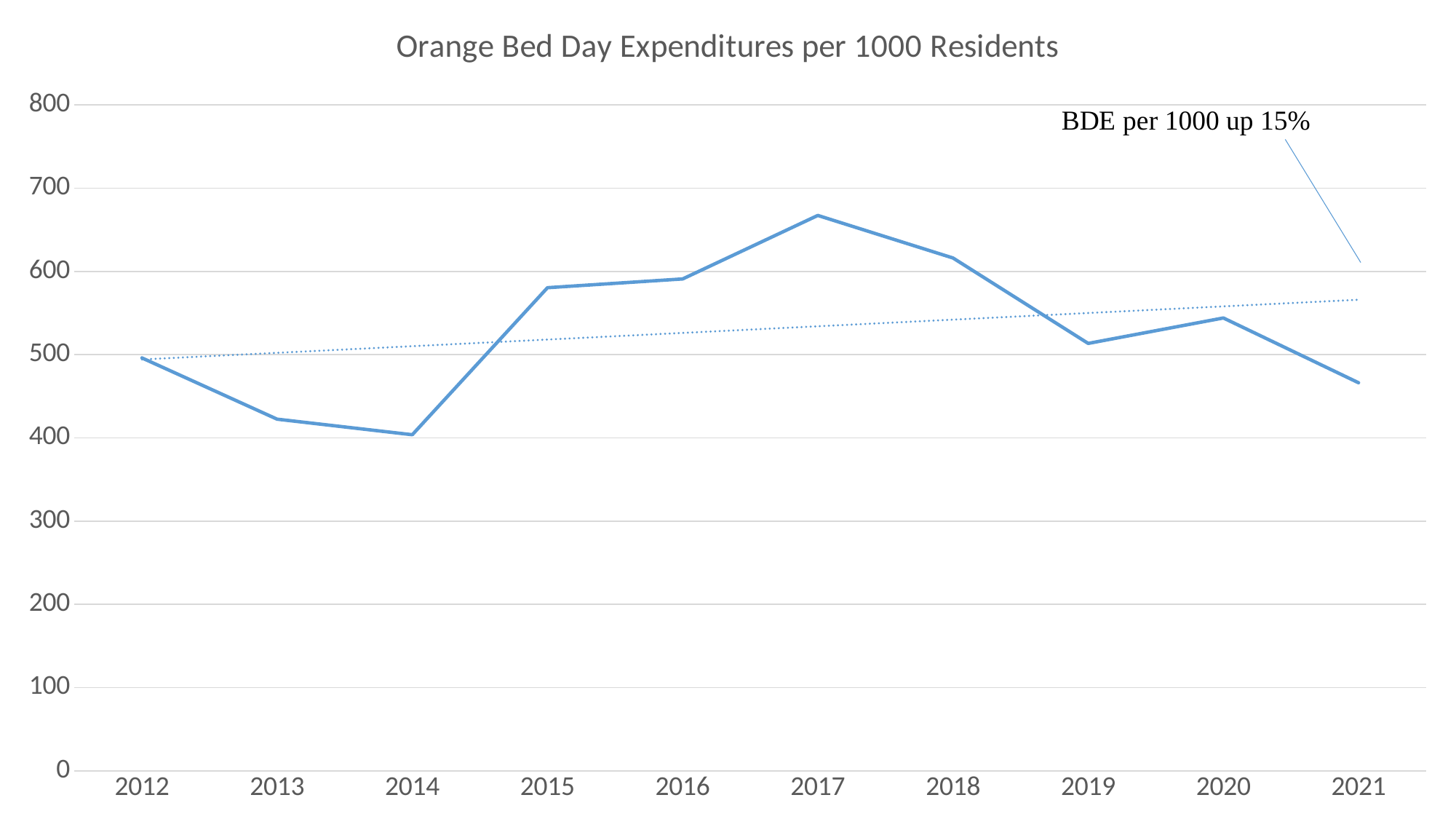
What does the text annotation on the chart say? BDE per 1000 up 15% What is the title of the chart? Orange Bed Day Expenditures per 1000 Residents Which year has the lowest value? 2014 Is the value for 2017 greater or less than 600? greater How many years are plotted along the x axis? 10 Which year has the highest value? 2017 Is the value for 2021 greater or less than 500? less Is the value for 2020 greater or less than 500? greater Which is larger, the value for 2015 or the value for 2014? 2015 What kind of chart is shown on the slide? Line chart Do the values rise or fall from 2017 to 2019? fall